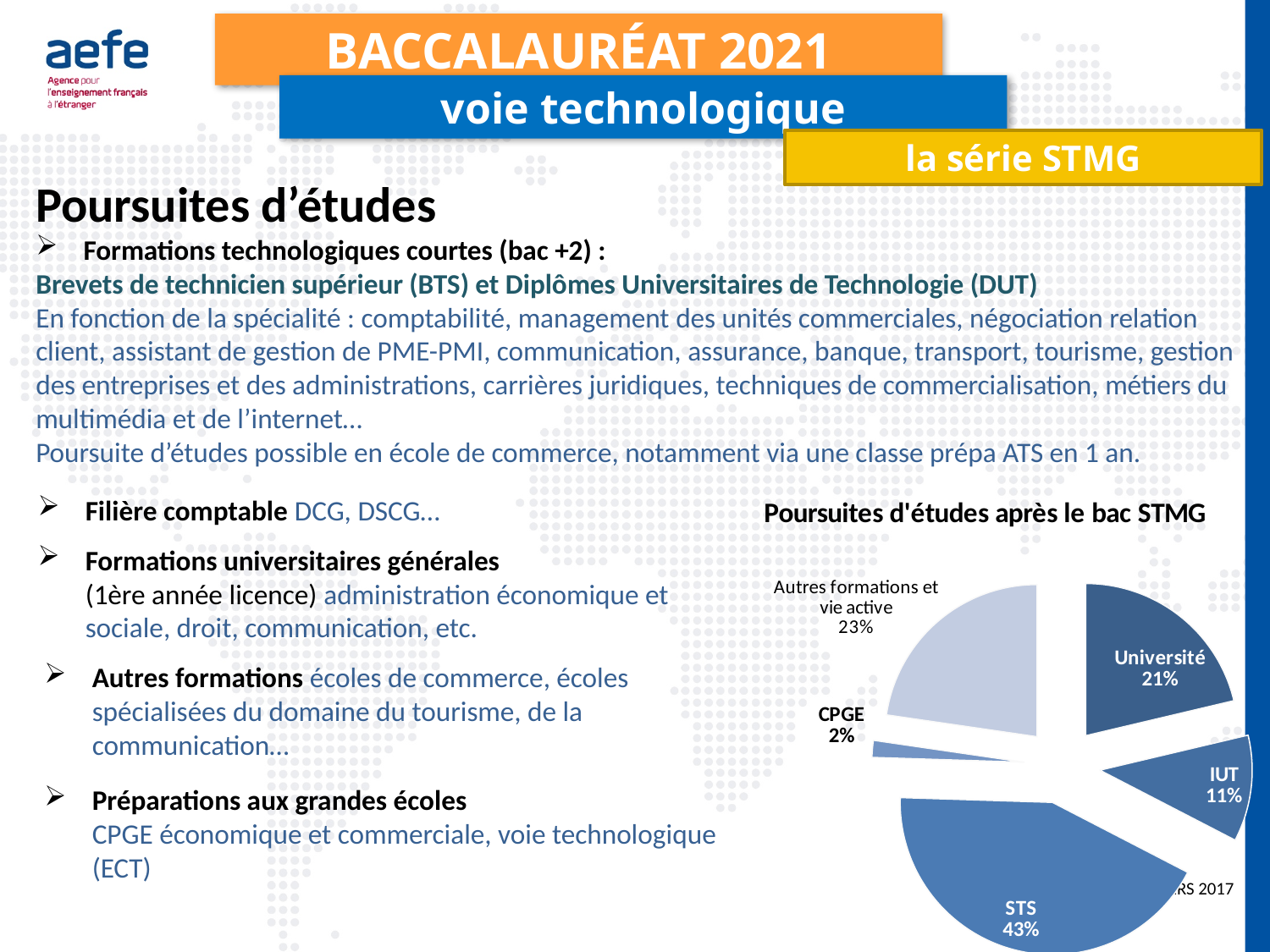
Which is larger, the share for IUT or the share for Université? Université What share of the pie is CPGE? 2% How many slices does the pie chart have? 5 Which slice of the pie is the largest? STS What is the difference between the STS share and the Université share? 22% What share of the pie is Université? 21% What share of the pie is IUT? 11% Which slice of the pie is the smallest? CPGE What type of chart is shown on the slide? pie chart What share of the pie is STS? 43% What share of the pie is Autres formations et vie active? 23% What is the title of the chart? Poursuites d'études après le bac STMG